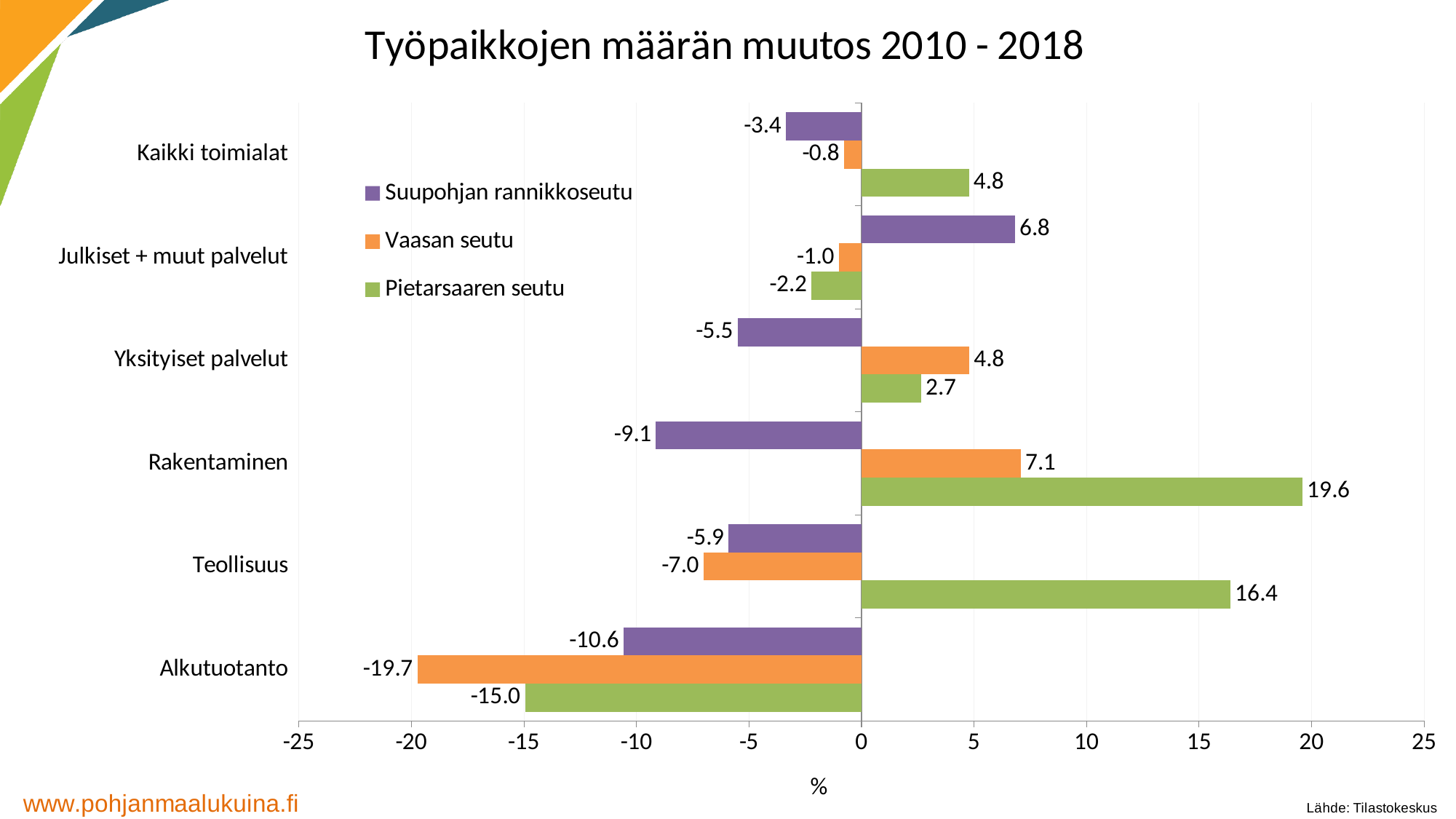
What is the value for Suupohjan rannikkoseutu in Kaikki toimialat? -3.4 What kind of chart is shown on the slide? bar chart What is the value for Vaasan seutu in Alkutuotanto? -19.7 In Yksityiset palvelut, which is larger: the value for Vaasan seutu or for Pietarsaaren seutu? Vaasan seutu Which category has the lowest value for Suupohjan rannikkoseutu? Alkutuotanto What is the difference between the Pietarsaaren seutu and Vaasan seutu values in Teollisuus? 23.4 Which category has the highest value for Pietarsaaren seutu? Rakentaminen What is the title of the chart? Työpaikkojen määrän muutos 2010 - 2018 What is the value for Pietarsaaren seutu in Rakentaminen? 19.6 How many categories are shown on the y axis? 6 Is the value for Pietarsaaren seutu in Teollisuus greater or less than 15? greater How many series does the legend list? 3